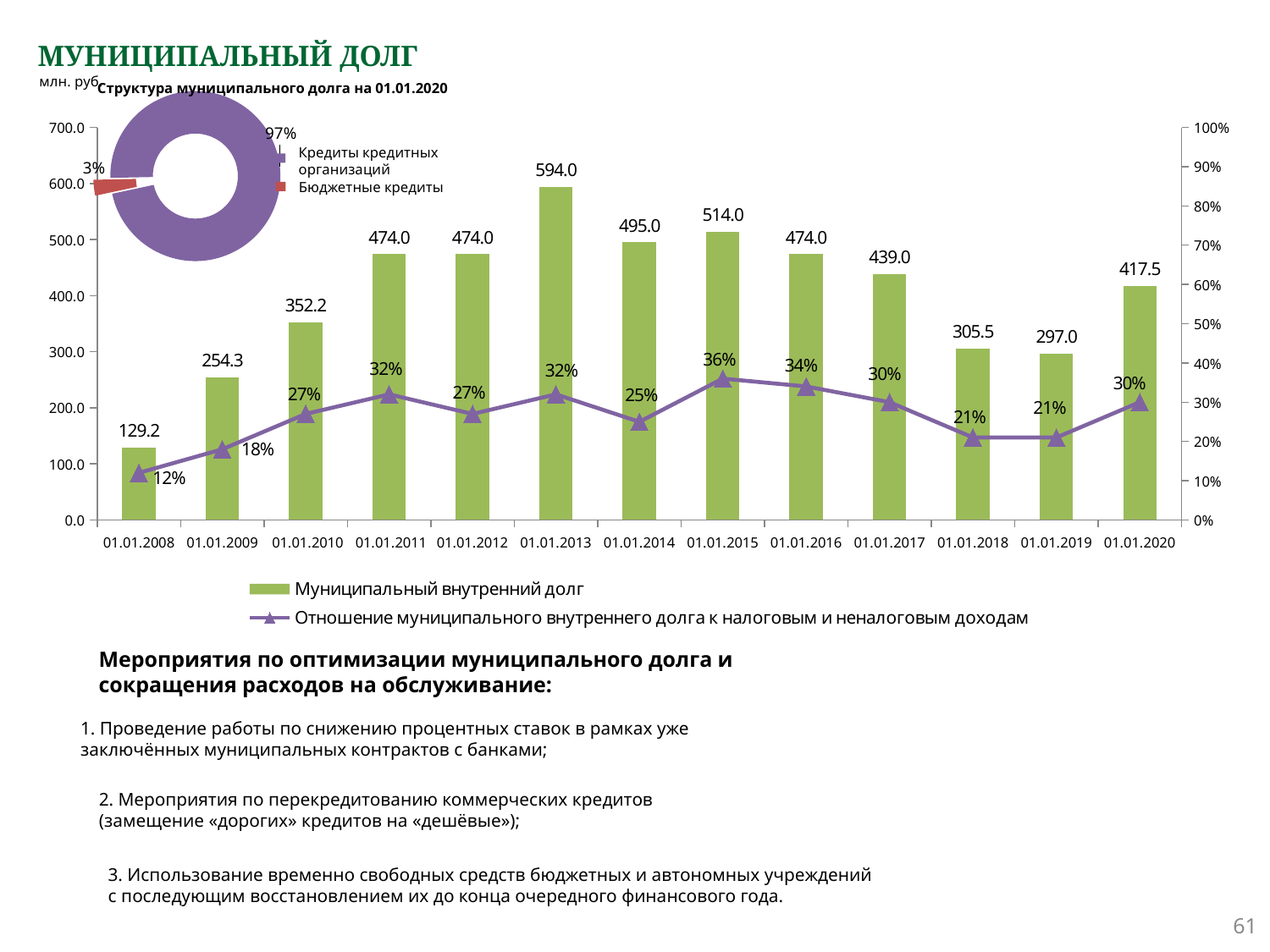
In the bar chart, on which date is Муниципальный внутренний долг the lowest? 01.01.2008 In the bar chart, how many dates are shown on the x axis? 13 In the chart titled Структура муниципального долга на 01.01.2020, what share is Кредиты кредитных организаций? 97% In the bar chart, what is the value of the line series (Отношение муниципального внутреннего долга к налоговым и неналоговым доходам) on 01.01.2015? 36% What kind of chart is the large chart on the slide? Bar chart with a line In the bar chart, what is the value of Муниципальный внутренний долг on 01.01.2013? 594.0 In the chart titled Структура муниципального долга на 01.01.2020, what share is Бюджетные кредиты? 3% In the bar chart, does Муниципальный внутренний долг rise or fall from 01.01.2008 to 01.01.2013? Rises In the bar chart, what is the difference between Муниципальный внутренний долг on 01.01.2020 and on 01.01.2019? 120.5 In the bar chart, on which date is Муниципальный внутренний долг the highest? 01.01.2013 In the bar chart, which is larger: Муниципальный внутренний долг on 01.01.2014 or on 01.01.2015? 01.01.2015 In the bar chart, how many series does the legend list? 2